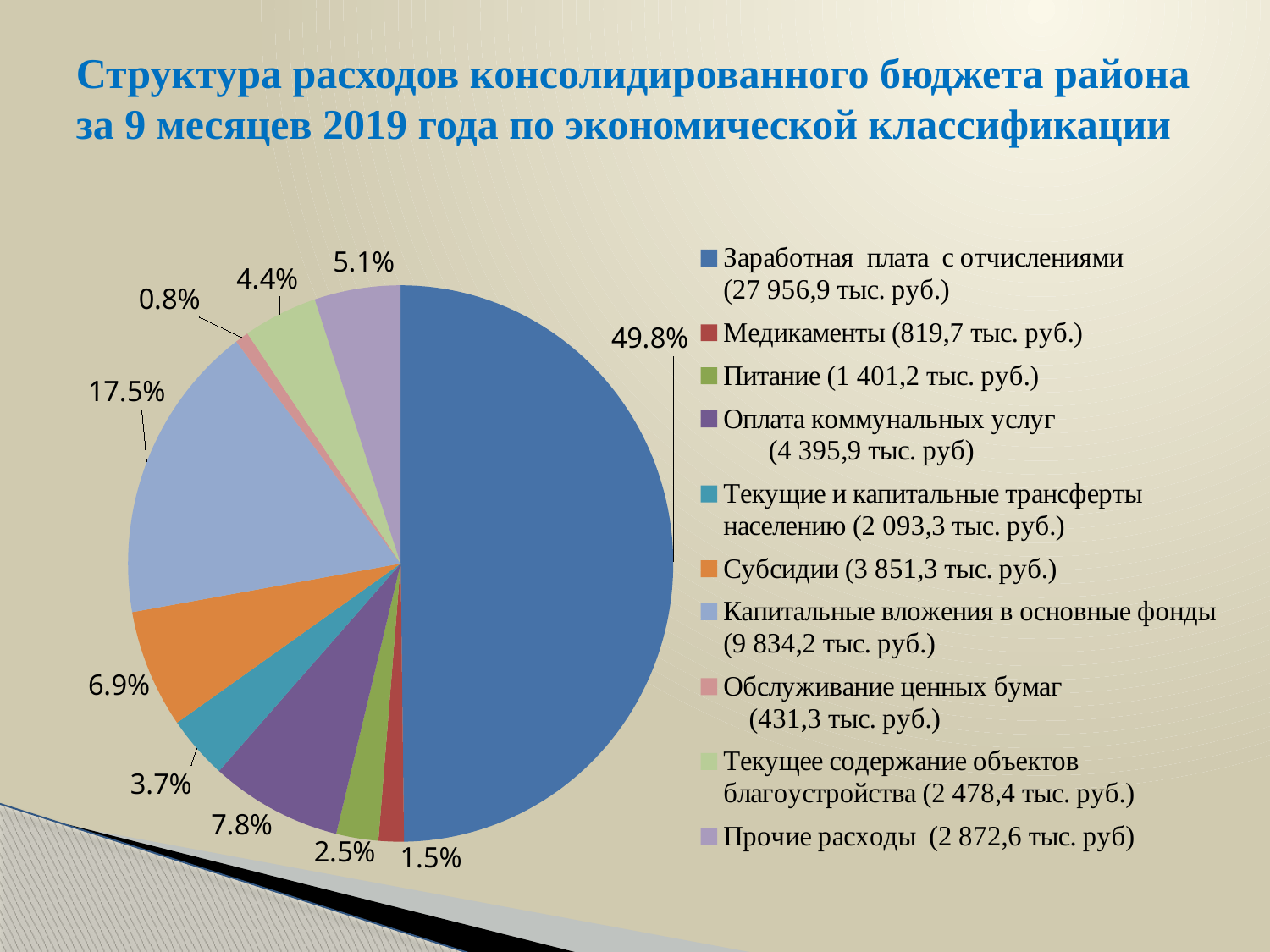
What share of the pie does "Заработная плата с отчислениями" have? 49.8% What percentage is shown for "Субсидии"? 6.9% What is the difference in percentage points between "Капитальные вложения в основные фонды" and "Субсидии"? 10.6 What percentage is shown for "Прочие расходы"? 5.1% Which category has the smallest slice of the pie? Обслуживание ценных бумаг What kind of chart is shown on the slide? pie chart Which category has the largest slice of the pie? Заработная плата с отчислениями Which is larger: the share for "Питание" or the share for "Медикаменты"? Питание What amount in thousand rubles does the legend give for "Медикаменты"? 819,7 тыс. руб. What percentage is shown for "Капитальные вложения в основные фонды"? 17.5% What percentage is shown for "Оплата коммунальных услуг"? 7.8% How many categories does the legend list? 10